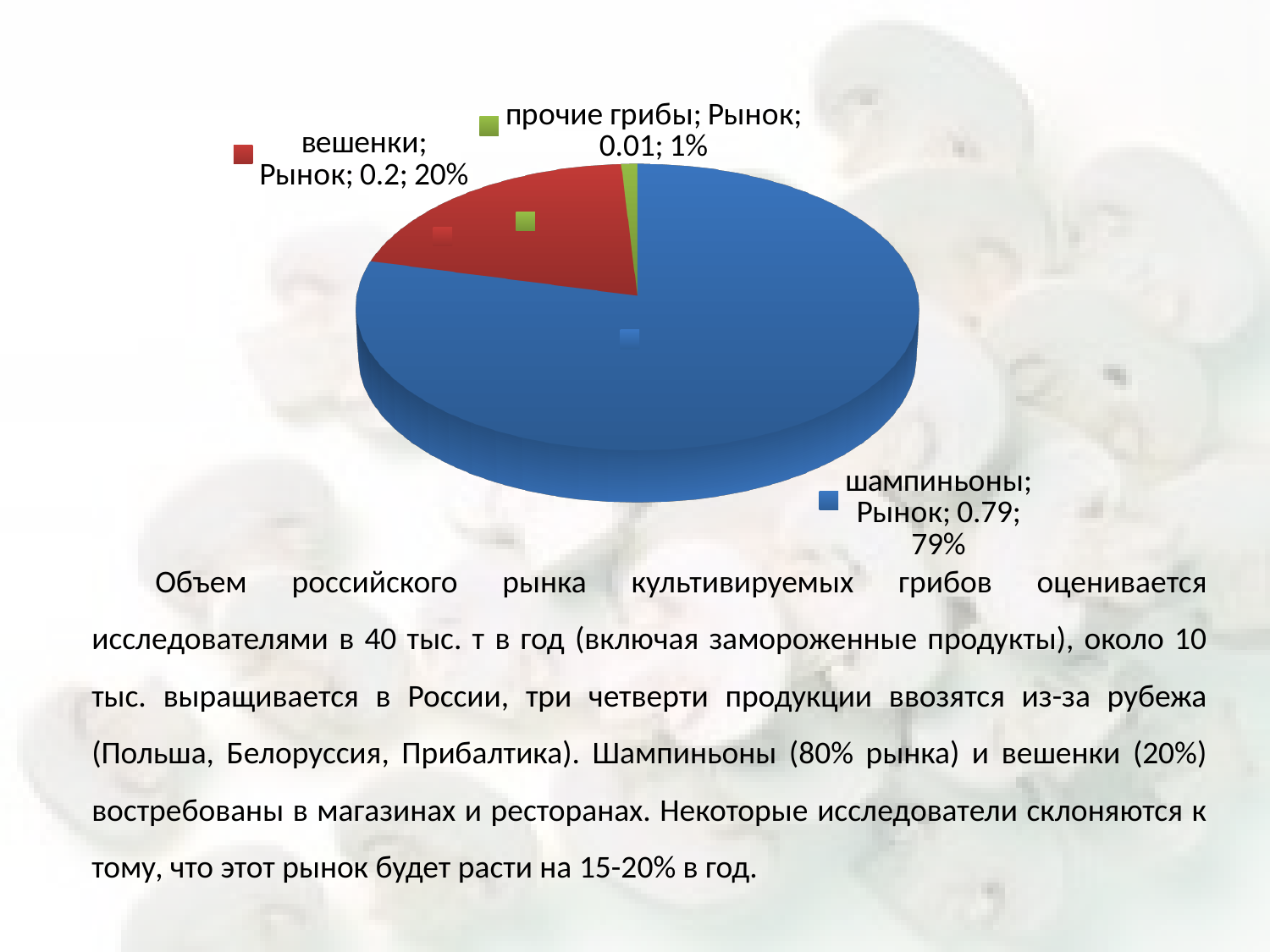
Which category has the smallest slice of the pie? прочие грибы Which is larger, the slice for вешенки or the slice for прочие грибы? вешенки What share of the pie does шампиньоны have? 79% How many slices does the pie chart have? 3 What kind of chart is shown on the slide? pie chart What is the value shown for вешенки? 0.2 What share of the pie does прочие грибы have? 1% Which category has the largest slice of the pie? шампиньоны What share of the pie does вешенки have? 20% What is the value shown for шампиньоны? 0.79 What is the difference in percentage points between the шампиньоны slice and the вешенки slice? 59 What is the value shown for прочие грибы? 0.01